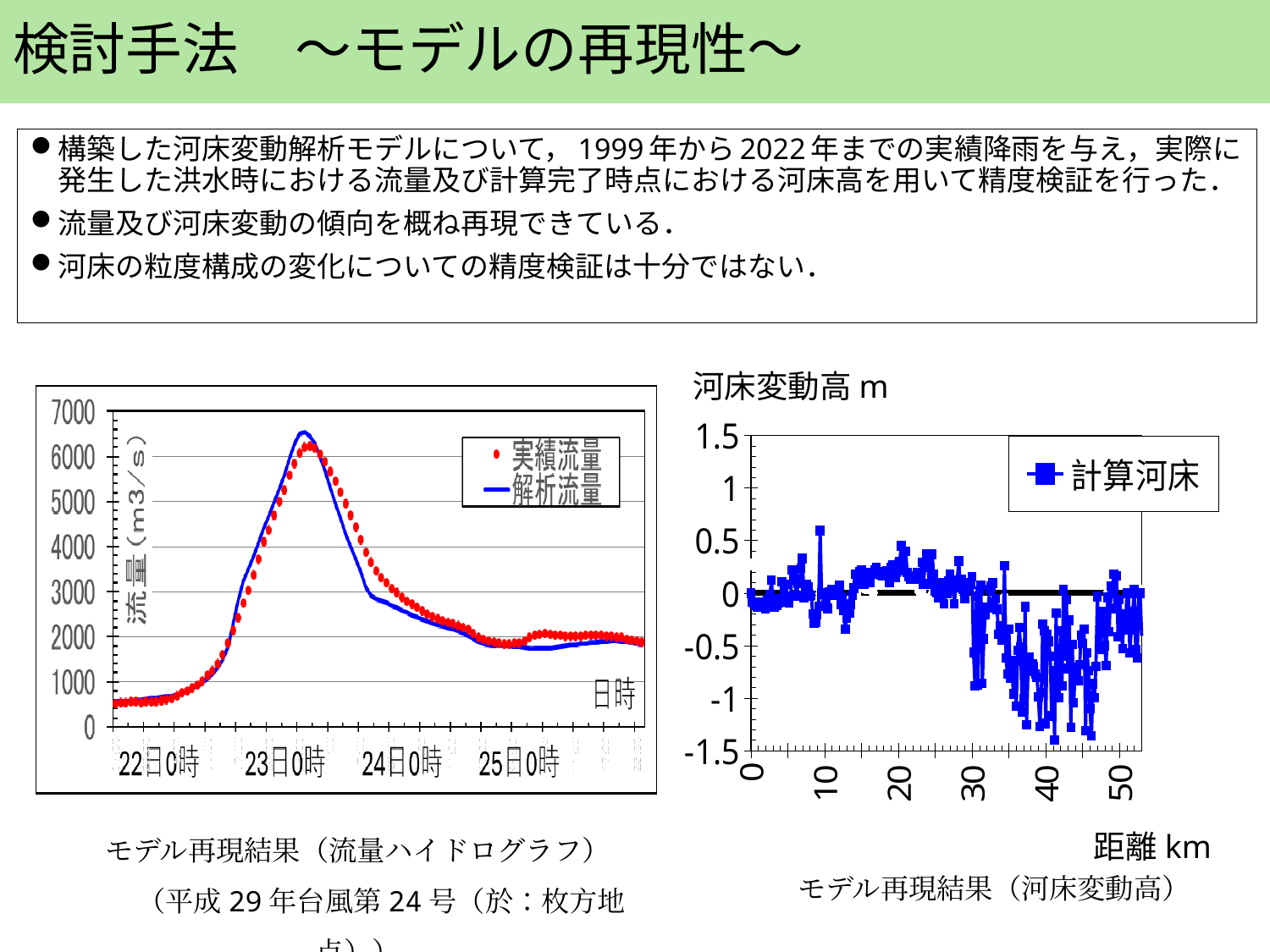
How many series does the legend of the right chart (河床変動高) list? 1 In the left chart (流量ハイドログラフ), is the value of 解析流量 at 25日0時 greater or less than 3000? less In the left chart (流量ハイドログラフ), is the peak value of 解析流量 greater or less than 6000? greater In the right chart (河床変動高), is the value of 計算河床 at 45 km greater or less than 0.5? less How many series does the legend of the left chart (流量ハイドログラフ) list? 2 In the left chart (流量ハイドログラフ), do the values rise or fall between 22日0時 and 23日0時? rise What are the two legend entries in the left chart (流量ハイドログラフ)? 実績流量, 解析流量 What kind of chart is the left chart (モデル再現結果（流量ハイドログラフ）)? line chart What is the legend entry shown in the right chart (河床変動高)? 計算河床 In the left chart (流量ハイドログラフ), do the values rise or fall between 23日0時 and 24日0時? fall